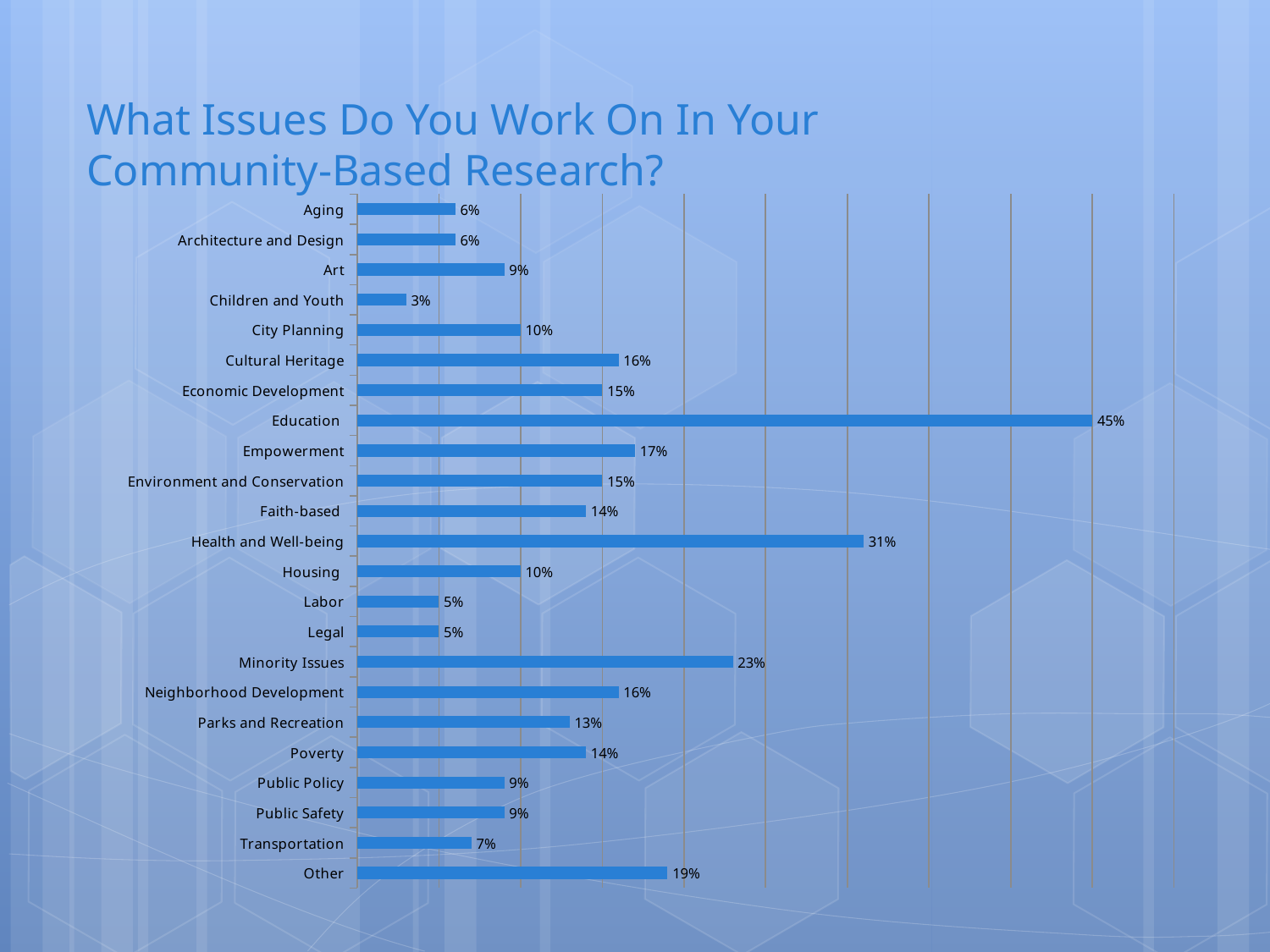
What is the difference between the values for Minority Issues and Other? 4% What is the value for Children and Youth? 3% How many categories are shown in the chart? 23 What is the value for Education? 45% What is the value for Minority Issues? 23% What is the title of the slide? What Issues Do You Work On In Your Community-Based Research? Which is larger, the value for Empowerment or the value for Faith-based? Empowerment Which category has the lowest value? Children and Youth What kind of chart is shown on the slide? Bar chart What is the difference between the values for Education and Health and Well-being? 14% What is the value for Health and Well-being? 31% Which category has the highest value? Education